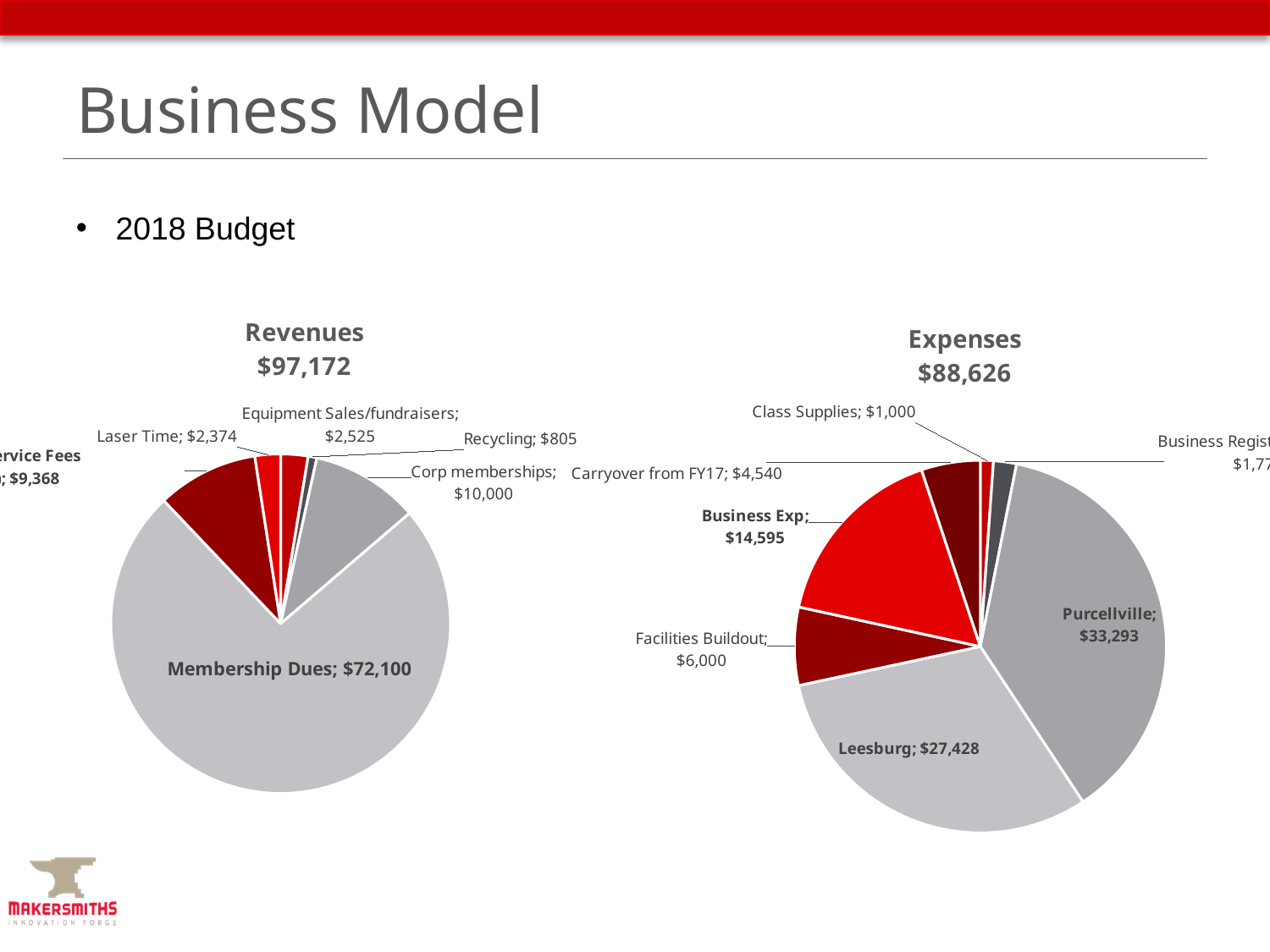
In the Revenues chart, what is the value for Corp memberships? $10,000 What kind of chart is used for the Revenues chart? pie chart In the Revenues chart, which category has the largest slice? Membership Dues In the Expenses chart, what is the value for Class Supplies? $1,000 In the Revenues chart, what is the difference between Equipment Sales/fundraisers and Laser Time? $151 In the Expenses chart, what is the value for Purcellville? $33,293 In the Revenues chart, which category has the smallest slice? Recycling In the Expenses chart, what is the value for Leesburg? $27,428 In the Expenses chart, what is the difference between Purcellville and Leesburg? $5,865 What total is shown under the Revenues chart title? $97,172 In the Revenues chart, what is the value for Membership Dues? $72,100 In the Expenses chart, which is larger, Business Exp or Facilities Buildout? Business Exp